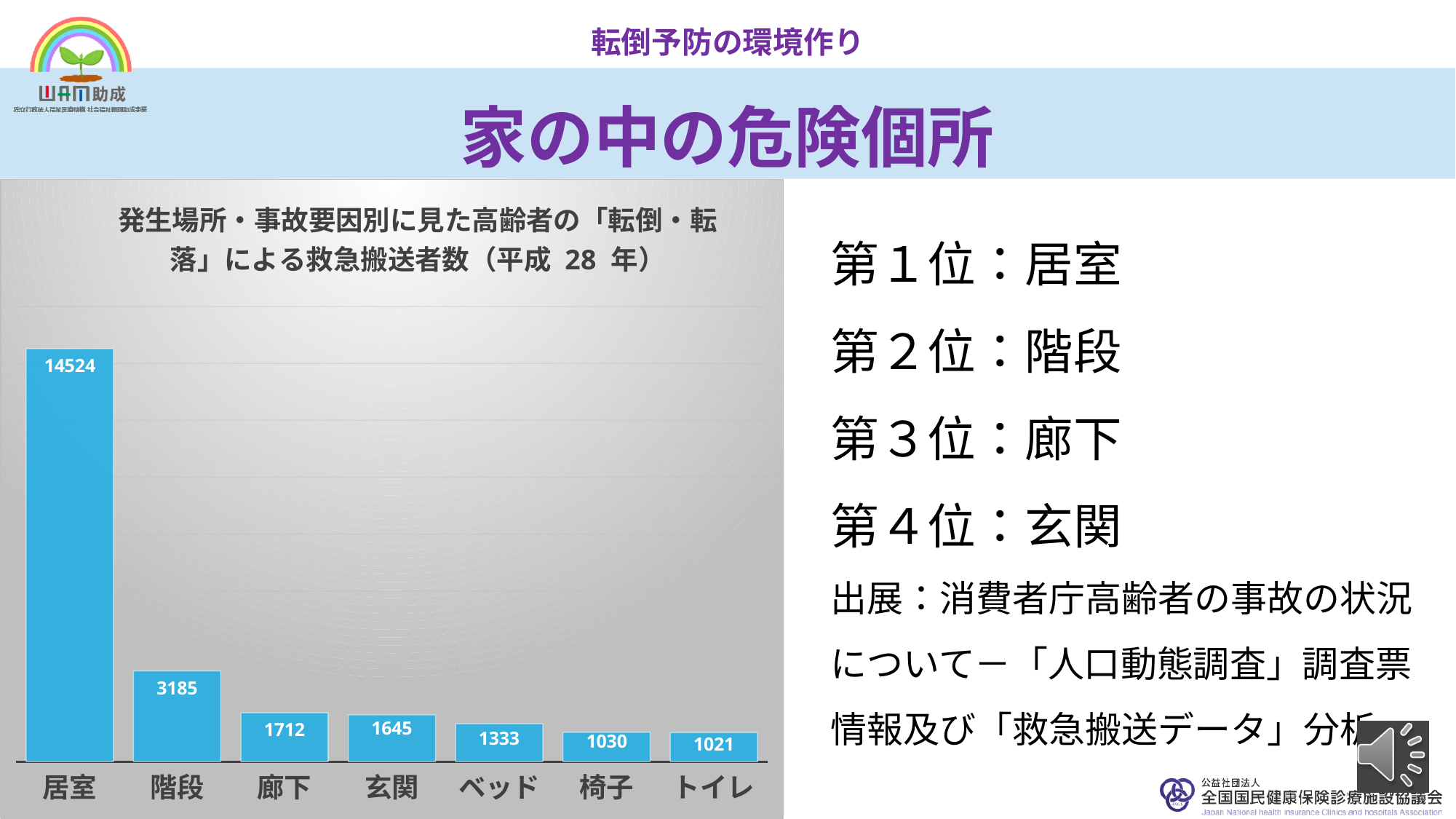
Do the values rise or fall from left to right along the x axis? fall Which is larger, the value for 椅子 or the value for ベッド? ベッド Which category has the highest value? 居室 What is the difference between the values for 廊下 and 玄関? 67 What is the difference between the values for 居室 and 階段? 11339 What is the value for 居室? 14524 What is the value for ベッド? 1333 What kind of chart is shown on the slide? bar chart What is the value for トイレ? 1021 What is the value for 階段? 3185 Which category has the lowest value? トイレ How many categories are shown on the x axis? 7